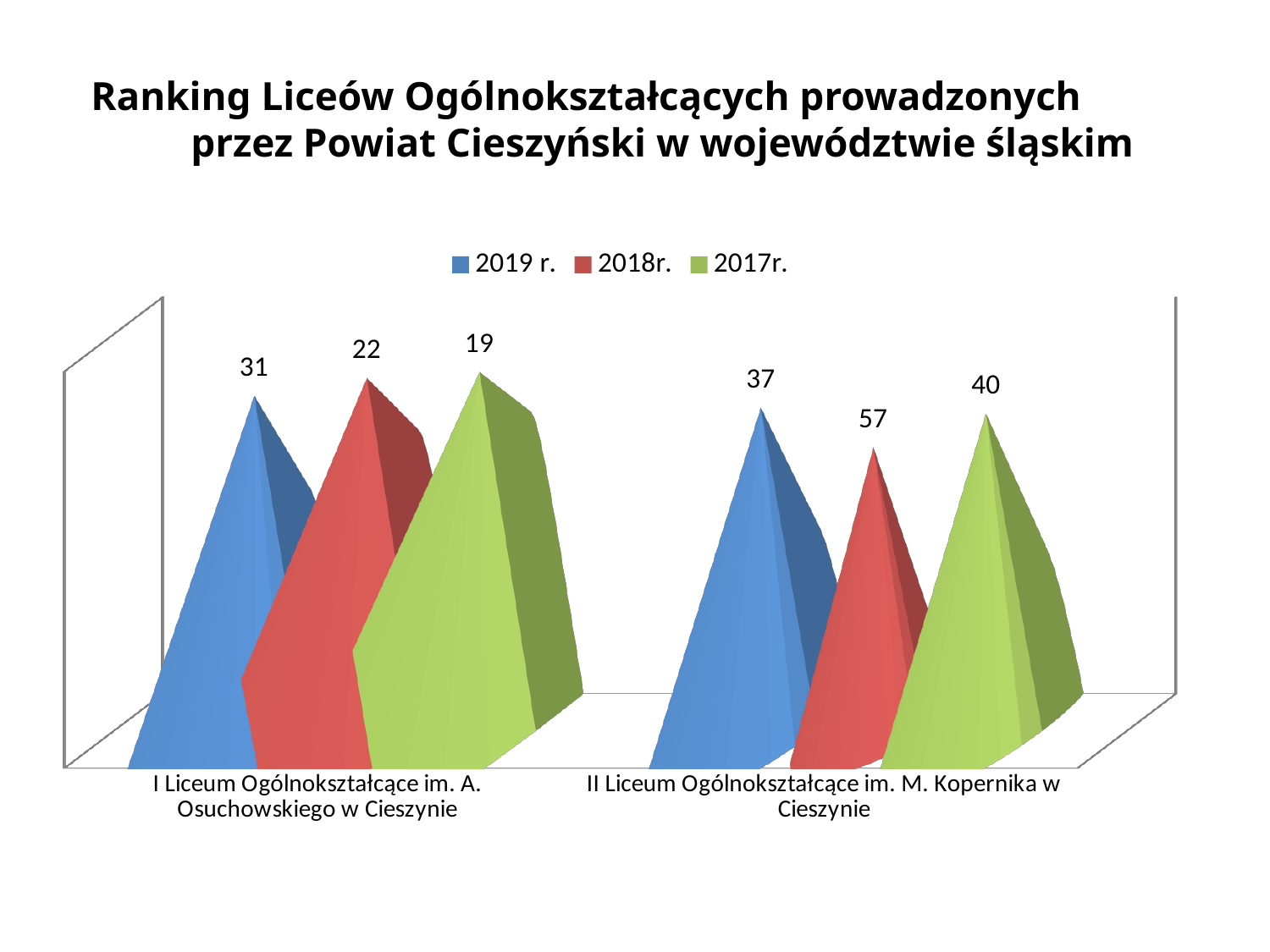
Which school has the larger 2018r. value, I Liceum Ogólnokształcące im. A. Osuchowskiego w Cieszynie or II Liceum Ogólnokształcące im. M. Kopernika w Cieszynie? II Liceum Ogólnokształcące im. M. Kopernika w Cieszynie Which year has the lowest value for I Liceum Ogólnokształcące im. A. Osuchowskiego w Cieszynie? 2017r. Which year has the highest value for II Liceum Ogólnokształcące im. M. Kopernika w Cieszynie? 2018r. What is the 2017r. value for II Liceum Ogólnokształcące im. M. Kopernika w Cieszynie? 40 How many schools (categories) are shown on the chart? 2 What is the 2019 r. value for I Liceum Ogólnokształcące im. A. Osuchowskiego w Cieszynie? 31 What is the difference between the 2019 r. values of II Liceum Ogólnokształcące im. M. Kopernika w Cieszynie and I Liceum Ogólnokształcące im. A. Osuchowskiego w Cieszynie? 6 What is the 2017r. value for I Liceum Ogólnokształcące im. A. Osuchowskiego w Cieszynie? 19 How many series does the legend list? 3 What is the 2018r. value for II Liceum Ogólnokształcące im. M. Kopernika w Cieszynie? 57 What is the difference between the 2018r. and 2017r. values for II Liceum Ogólnokształcące im. M. Kopernika w Cieszynie? 17 Which colour represents the 2017r. series in the legend? Green